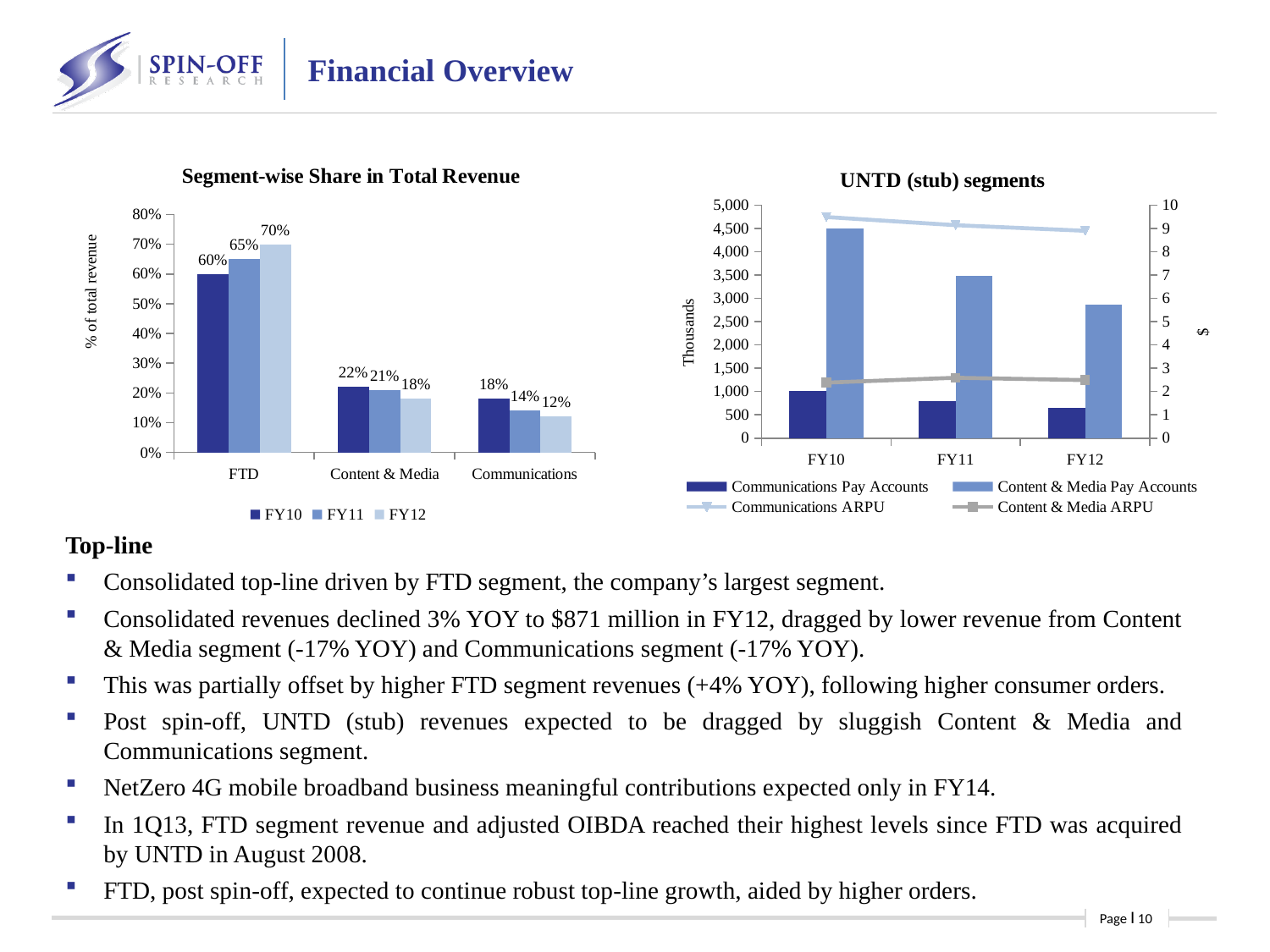
In the 'Segment-wise Share in Total Revenue' chart, which segment has the highest FY10 share? FTD In the 'Segment-wise Share in Total Revenue' chart, by how many percentage points did FTD's share increase from FY10 to FY12? 10 percentage points In the 'UNTD (stub) segments' chart, do Content & Media Pay Accounts rise or fall from FY10 to FY12? Fall In the 'UNTD (stub) segments' chart, is the value for Content & Media Pay Accounts in FY10 greater or less than 4,000? greater In the 'Segment-wise Share in Total Revenue' chart, which segment has the lowest FY12 share? Communications In the 'Segment-wise Share in Total Revenue' chart, what is the FY12 share for FTD? 70% In the 'Segment-wise Share in Total Revenue' chart, what is the FY11 share for Communications? 14% How many series does the legend of the 'Segment-wise Share in Total Revenue' chart list? 3 How many series does the legend of the 'UNTD (stub) segments' chart list? 4 In the 'Segment-wise Share in Total Revenue' chart, which is larger in FY10: Content & Media or Communications? Content & Media What kind of chart is the 'UNTD (stub) segments' chart? Combined bar and line chart In the 'Segment-wise Share in Total Revenue' chart, does FTD's share rise or fall from FY10 to FY12? Rise